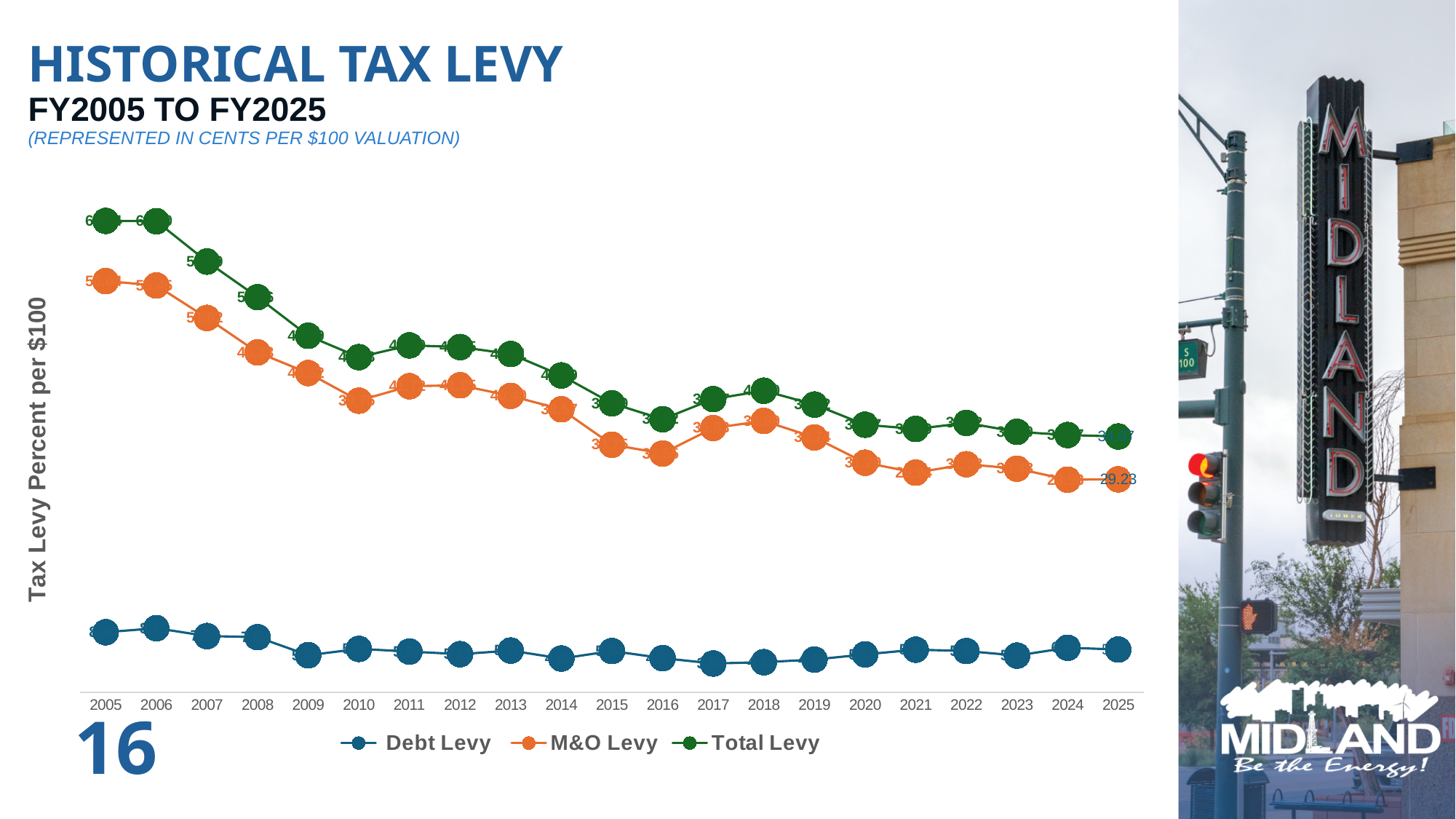
In 2025, which is larger, the Debt Levy or the M&O Levy? M&O Levy What are the three series named in the legend? Debt Levy, M&O Levy, Total Levy Does the Total Levy generally rise or fall from 2005 to 2025? fall Is the Total Levy higher in 2005 or in 2025? 2005 How many series does the legend list? 3 What kind of chart is shown on the slide? line chart Is the M&O Levy higher in 2005 or in 2016? 2005 What is the label on the y axis? Tax Levy Percent per $100 What is the M&O Levy value for 2025? 29.23 Which series has the lowest values across all years? Debt Levy How many years are plotted along the x axis? 21